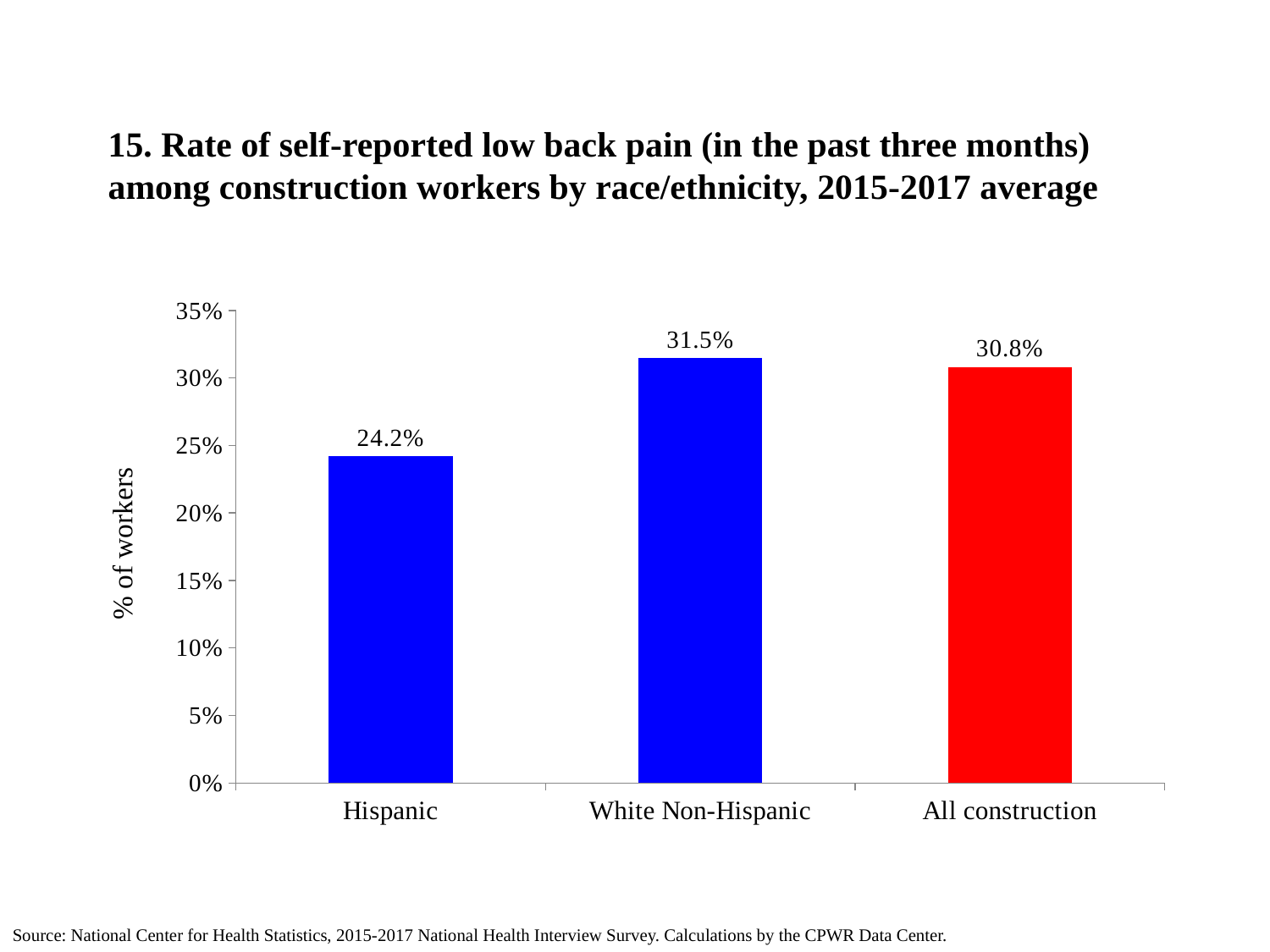
Is the value for Hispanic workers greater or less than 25%? less Which category has the highest rate of self-reported low back pain? White Non-Hispanic What kind of chart is shown on the slide? Bar chart What is the difference in percentage points between the White Non-Hispanic rate and the Hispanic rate? 7.3 percentage points What is the rate of self-reported low back pain for All construction workers? 30.8% What is the rate of self-reported low back pain for Hispanic construction workers? 24.2% Which is larger, the rate for Hispanic workers or the rate for All construction workers? All construction What is the label on the vertical axis of the chart? % of workers How many categories are shown on the x axis of the chart? 3 What is the rate of self-reported low back pain for White Non-Hispanic construction workers? 31.5% What is the difference in percentage points between the All construction rate and the Hispanic rate? 6.6 percentage points Which category has the lowest rate of self-reported low back pain? Hispanic